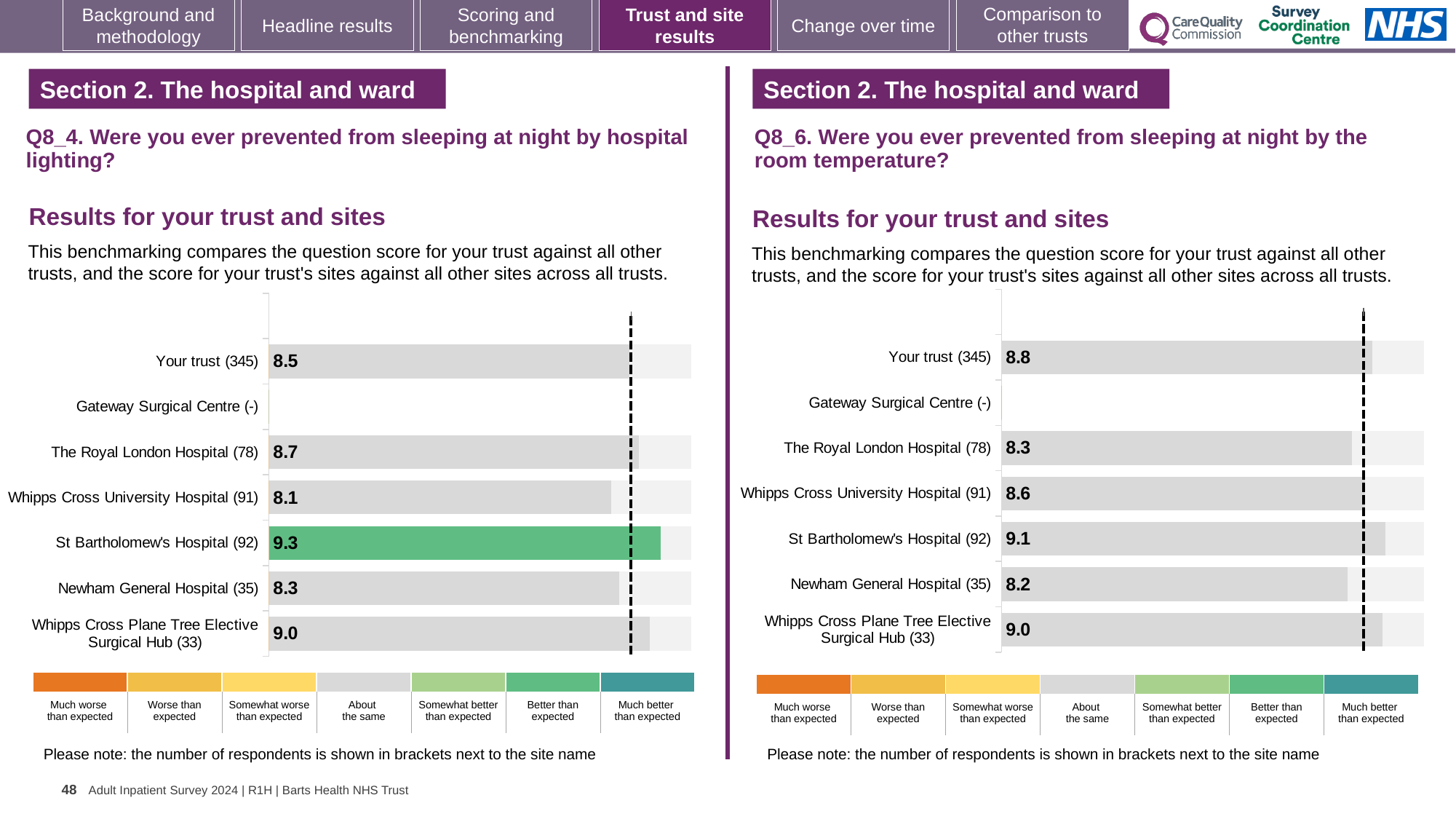
On the Q8_4 hospital lighting chart, what is the score for Your trust? 8.5 On the Q8_6 room temperature chart, which site has the lowest score? Newham General Hospital On the Q8_4 hospital lighting chart, what is the score for St Bartholomew's Hospital? 9.3 On the Q8_6 room temperature chart, which site has the highest score? St Bartholomew's Hospital On the Q8_6 room temperature chart, what is the score for Your trust? 8.8 On the Q8_4 hospital lighting chart, which site has the lowest score? Whipps Cross University Hospital On the Q8_4 hospital lighting chart, which site is shown with a green bar? St Bartholomew's Hospital On the Q8_6 room temperature chart, what is the difference between the scores for St Bartholomew's Hospital and The Royal London Hospital? 0.8 On the Q8_4 hospital lighting chart, what is the difference between the scores for St Bartholomew's Hospital and Newham General Hospital? 1.0 On the Q8_6 room temperature chart, what is the score for Whipps Cross University Hospital? 8.6 On the Q8_6 room temperature chart, which is higher: The Royal London Hospital or Whipps Cross Plane Tree Elective Surgical Hub? Whipps Cross Plane Tree Elective Surgical Hub What kind of chart is used on the Q8_4 hospital lighting chart? Bar chart